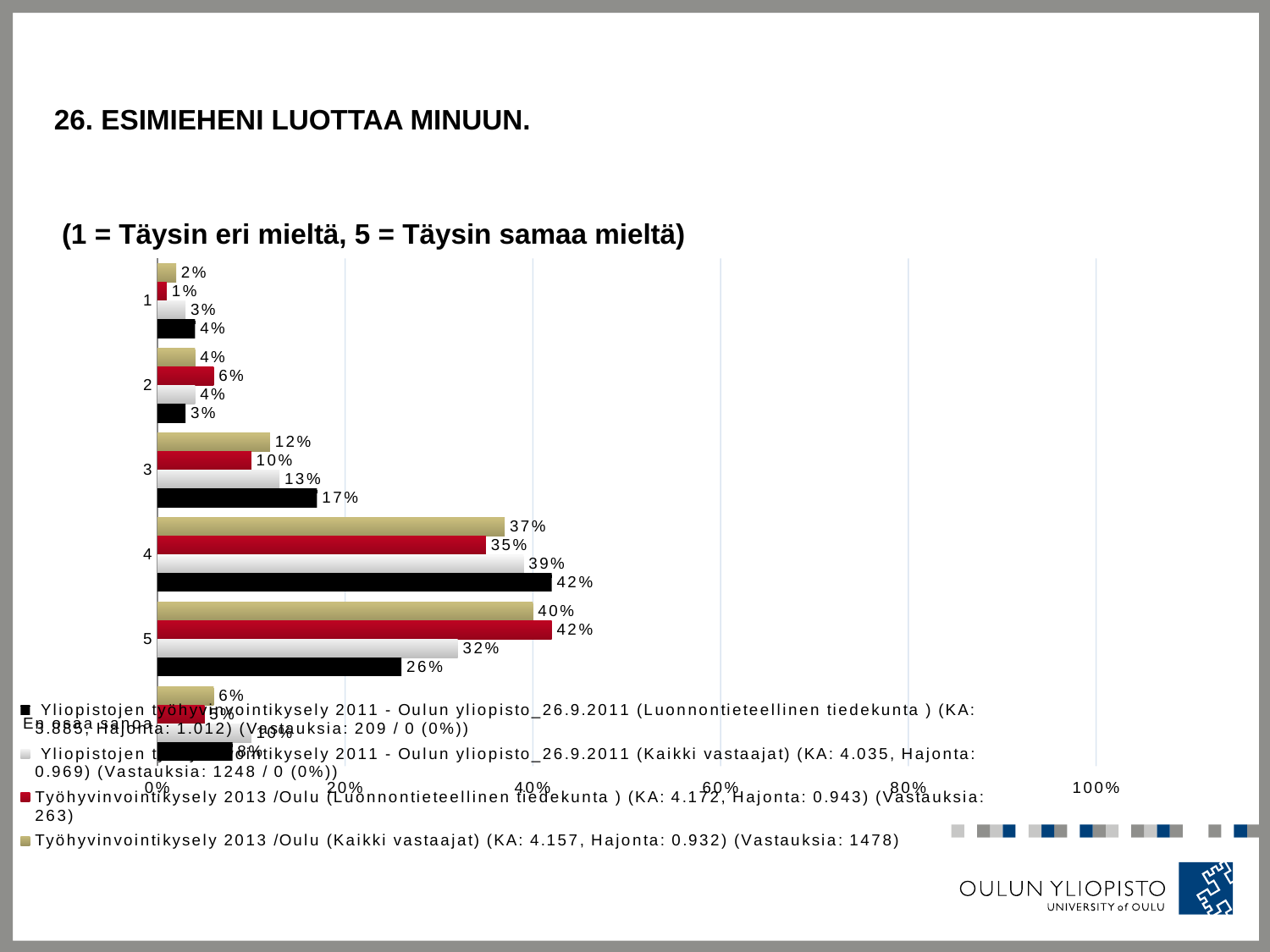
What is the value for category 4 in the series 'Yliopistojen työhyvinvointikysely 2011 - Oulun yliopisto_26.9.2011 (Luonnontieteellinen tiedekunta)'? 42% What is the value for category 3 in the series 'Työhyvinvointikysely 2013 /Oulu (Kaikki vastaajat)'? 12% What is the value for category 5 in the series 'Yliopistojen työhyvinvointikysely 2011 - Oulun yliopisto_26.9.2011 (Kaikki vastaajat)'? 32% For category 5, what is the difference between the 'Työhyvinvointikysely 2013 /Oulu (Luonnontieteellinen tiedekunta)' value and the 'Yliopistojen työhyvinvointikysely 2011 - Oulun yliopisto_26.9.2011 (Luonnontieteellinen tiedekunta)' value? 16 percentage points For category 4, which is larger: the 'Yliopistojen työhyvinvointikysely 2011 - Oulun yliopisto_26.9.2011 (Kaikki vastaajat)' value or the 'Työhyvinvointikysely 2013 /Oulu (Kaikki vastaajat)' value? Yliopistojen työhyvinvointikysely 2011 - Oulun yliopisto_26.9.2011 (Kaikki vastaajat) What is the title of the chart? 26. ESIMIEHENI LUOTTAA MINUUN. What type of chart is shown on the slide? bar chart In the series 'Yliopistojen työhyvinvointikysely 2011 - Oulun yliopisto_26.9.2011 (Luonnontieteellinen tiedekunta)', which category has the highest value? 4 In the series 'Työhyvinvointikysely 2013 /Oulu (Luonnontieteellinen tiedekunta)', which category has the highest value? 5 How many series does the legend list? 4 What is the value for category 5 in the series 'Työhyvinvointikysely 2013 /Oulu (Luonnontieteellinen tiedekunta)'? 42% For category 3, what is the difference between the 'Yliopistojen työhyvinvointikysely 2011 - Oulun yliopisto_26.9.2011 (Luonnontieteellinen tiedekunta)' value and the 'Työhyvinvointikysely 2013 /Oulu (Luonnontieteellinen tiedekunta)' value? 7 percentage points